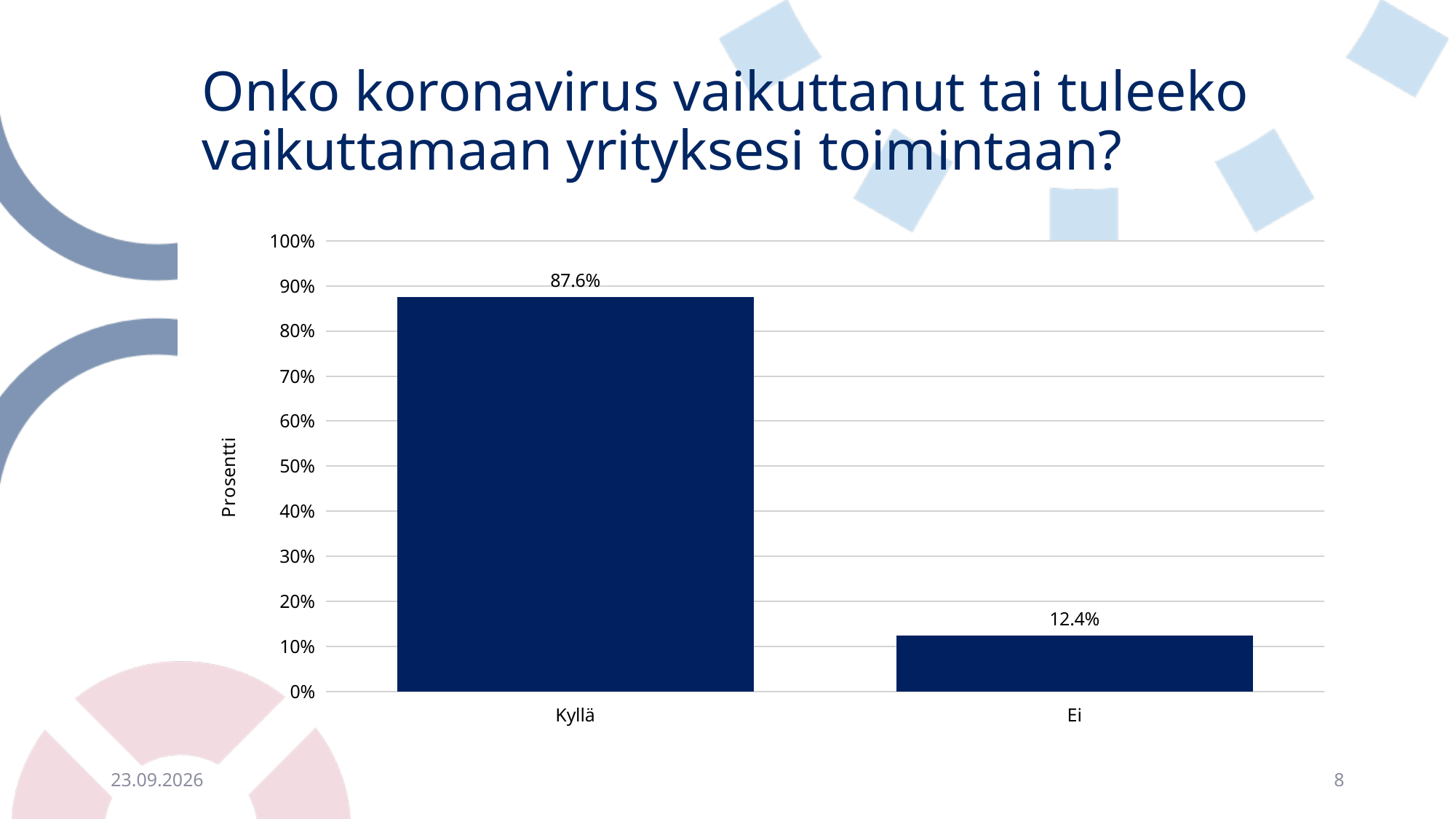
Which is larger, the value for Kyllä or the value for Ei? Kyllä What is the value for Kyllä? 87.6% What kind of chart is shown on the slide? bar chart Is the value for Ei greater or less than 20%? less How many categories are shown on the x axis? 2 Which category has the highest value? Kyllä What is the total of the values for Kyllä and Ei? 100.0% What is the label of the vertical axis? Prosentti What is the difference between the values for Kyllä and Ei? 75.2% Is the value for Kyllä greater or less than 80%? greater Which category has the lowest value? Ei What is the value for Ei? 12.4%